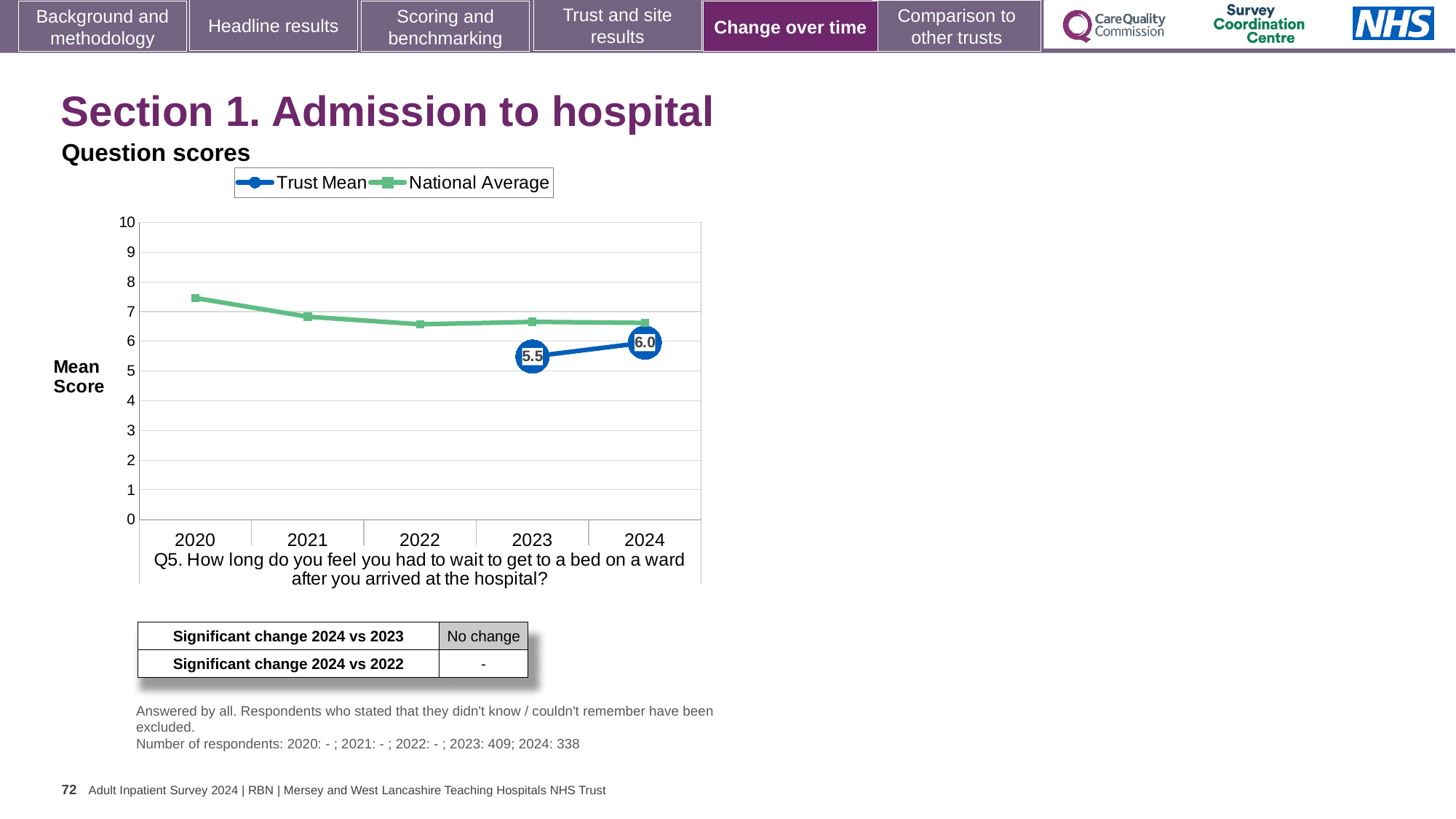
What is the Trust Mean score for 2024? 6.0 Is the National Average value for 2020 greater or less than 7? greater What is the Trust Mean score for 2023? 5.5 Is the Trust Mean value for 2023 greater or less than 6? less How many series does the chart legend list? 2 What type of chart is used to show the question scores? line chart Does the Trust Mean rise or fall from 2023 to 2024? rise In which year is the National Average at its highest? 2020 By how much did the Trust Mean score change from 2023 to 2024? 0.5 How many years are shown on the x axis of the chart? 5 In 2024, which series has the higher value, Trust Mean or National Average? National Average Which year has the higher Trust Mean score, 2023 or 2024? 2024